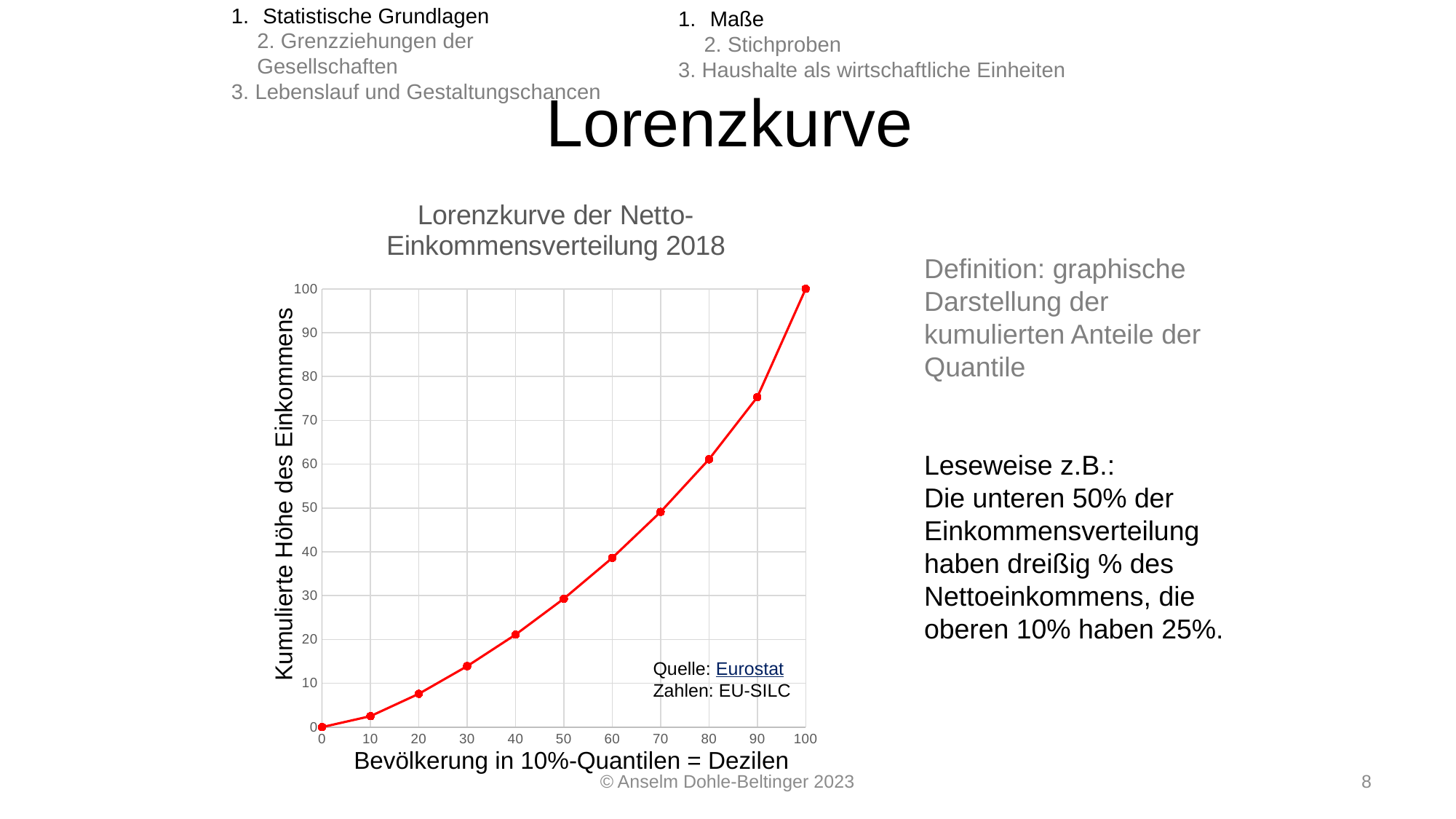
What is the title of the chart? Lorenzkurve der Netto-Einkommensverteilung 2018 Do the values rise or fall as x increases from 0 to 100? rise Is the value of the curve at x = 50 greater or less than 20? greater Is the value of the curve at x = 20 greater or less than 10? less What is the label of the x axis of the chart? Bevölkerung in 10%-Quantilen = Dezilen What kind of chart is shown on the slide? line chart How many data points are plotted on the curve? 11 At which x value is the curve highest? 100 What is the value of the curve at x = 100? 100 Is the value of the curve at x = 90 greater or less than 70? greater Which is larger: the value of the curve at x = 90 or at x = 50? x = 90 What is the value of the curve at x = 0? 0